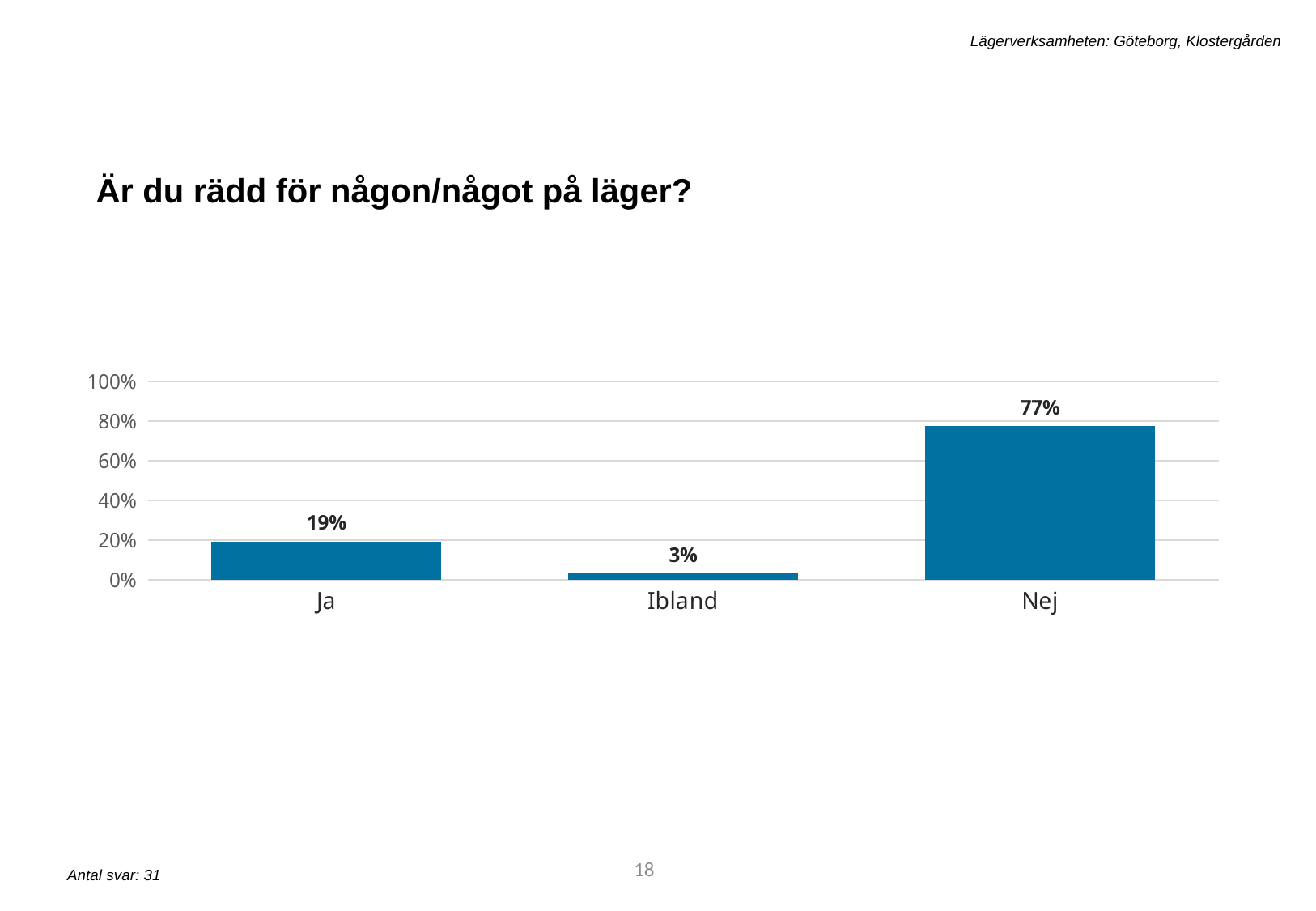
Which category has the lowest value? Ibland What is the value for Ja? 19% How many categories are shown on the x axis? 3 Which category has the highest value? Nej What is the difference between the values for Ja and Ibland? 16% What is the value for Ibland? 3% What is the difference between the values for Nej and Ja? 58% Is the value for Nej greater or less than 60%? greater What kind of chart is shown on the slide? bar chart What is the value for Nej? 77% Which is larger, the value for Ja or the value for Ibland? Ja What is the title of the chart? Är du rädd för någon/något på läger?